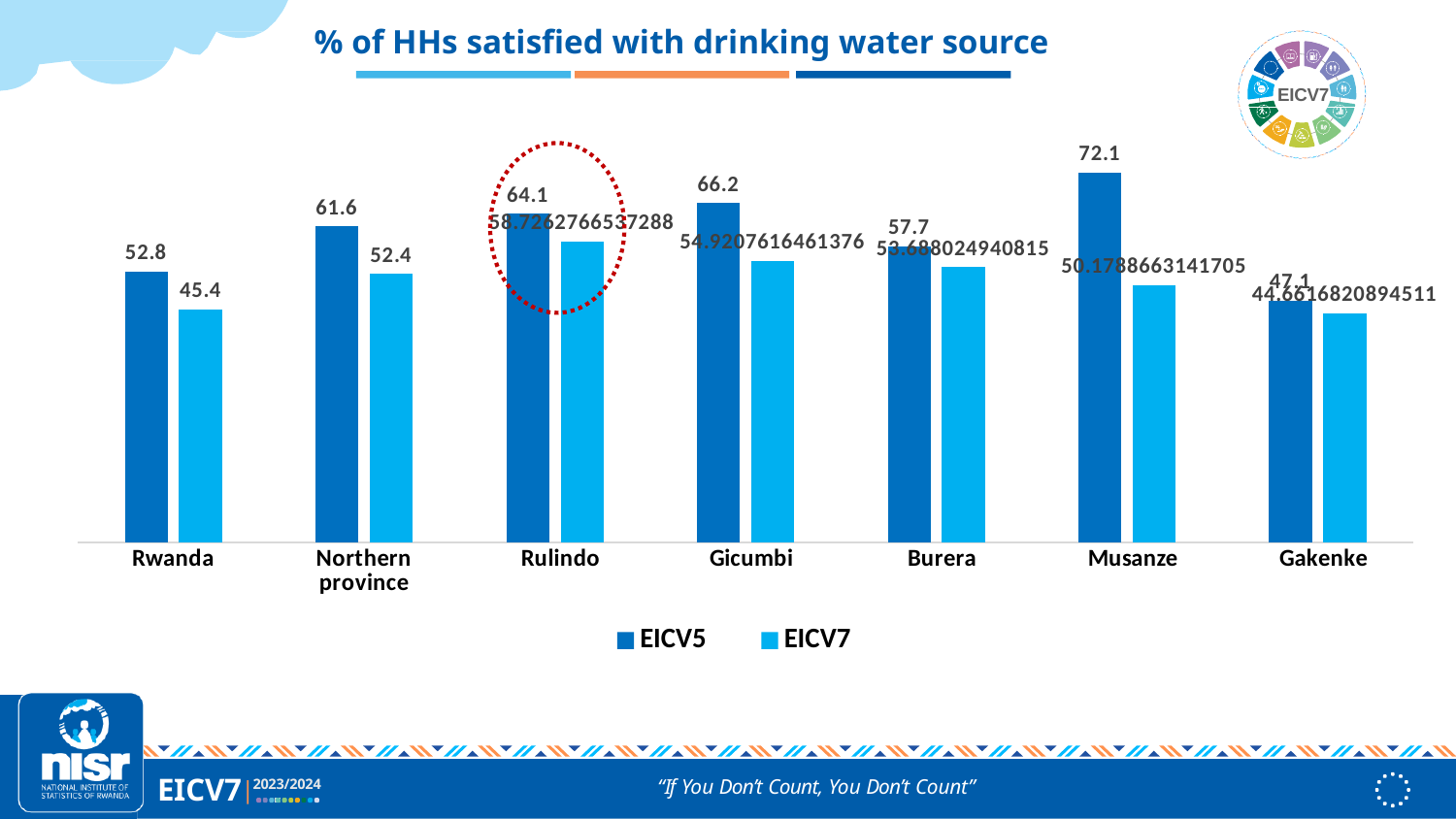
Which is larger for Rulindo, the EICV5 value or the EICV7 value? EICV5 What is the EICV5 value for Musanze? 72.1 What is the difference between the EICV5 and EICV7 values for Northern province? 9.2 How many categories are shown on the x axis? 7 What kind of chart is shown on the slide? Bar chart Which category has the highest EICV5 value? Musanze What is the EICV5 value for Rwanda? 52.8 What is the EICV5 value for Gicumbi? 66.2 What is the difference between the EICV5 and EICV7 values for Rwanda? 7.4 Which category has the lowest EICV5 value? Gakenke What is the EICV7 value for Northern province? 52.4 How many series does the legend list? 2